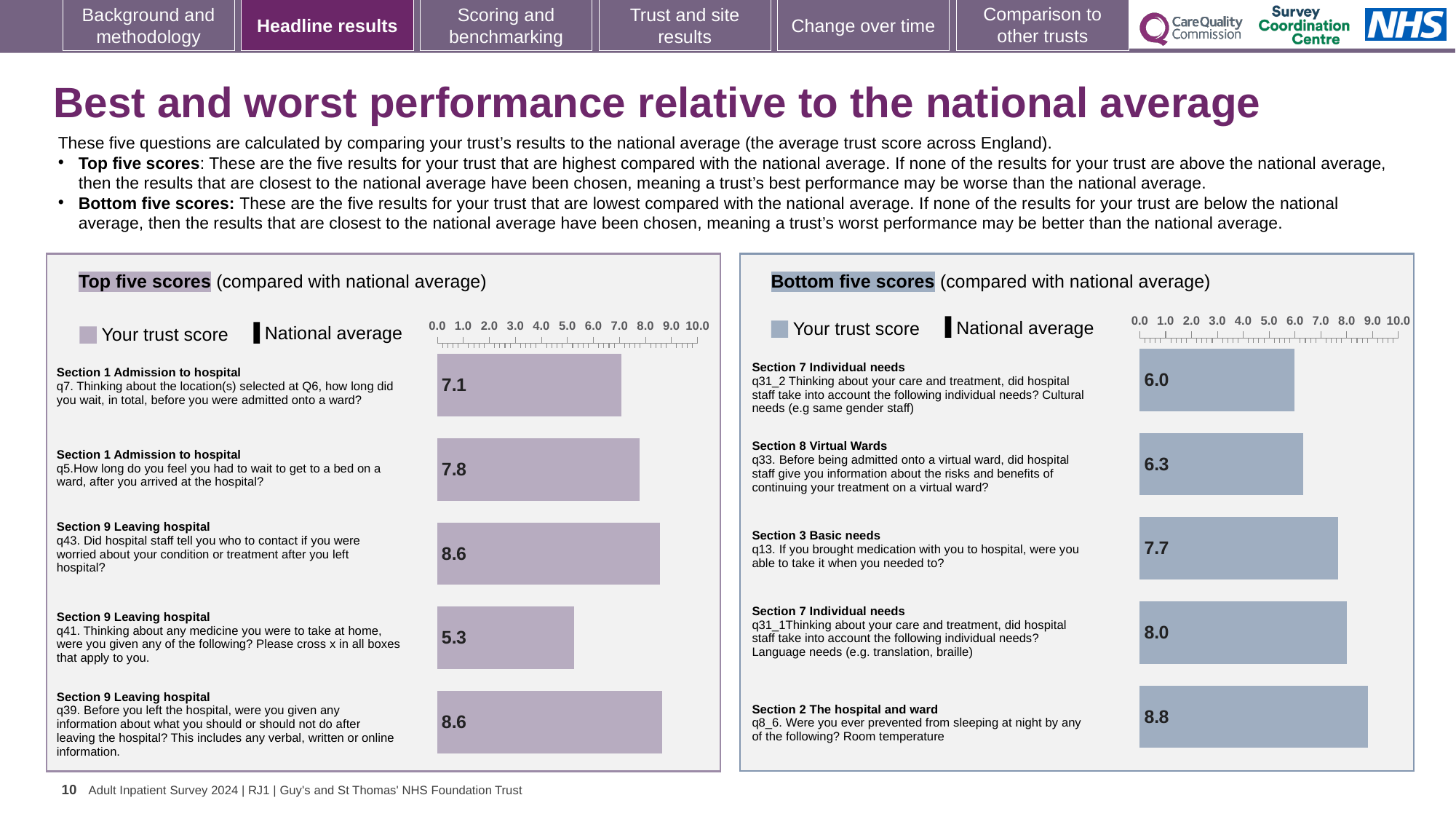
In the Top five scores chart, which question has the lowest trust score? q41 In the Bottom five scores chart, which question has the highest trust score? q8_6 How many questions are plotted in the Top five scores chart? 5 In the Bottom five scores chart, what is the trust score for q33 (information about risks and benefits of a virtual ward)? 6.3 In the Bottom five scores chart, which question has the lowest trust score? q31_2 In the Top five scores chart, what is the difference between the trust scores for q5 and q7? 0.7 In the Top five scores chart, what is the trust score for q7 (how long did you wait before being admitted onto a ward)? 7.1 In the Bottom five scores chart, which has the larger trust score, q13 or q31_1? q31_1 What kind of chart is the Bottom five scores chart? Bar chart In the Bottom five scores chart, what is the difference between the trust scores for q8_6 and q31_2? 2.8 In the Top five scores chart, what is the trust score for q41 (medicine to take at home)? 5.3 In the Bottom five scores chart, what is the trust score for q8_6 (prevented from sleeping by room temperature)? 8.8